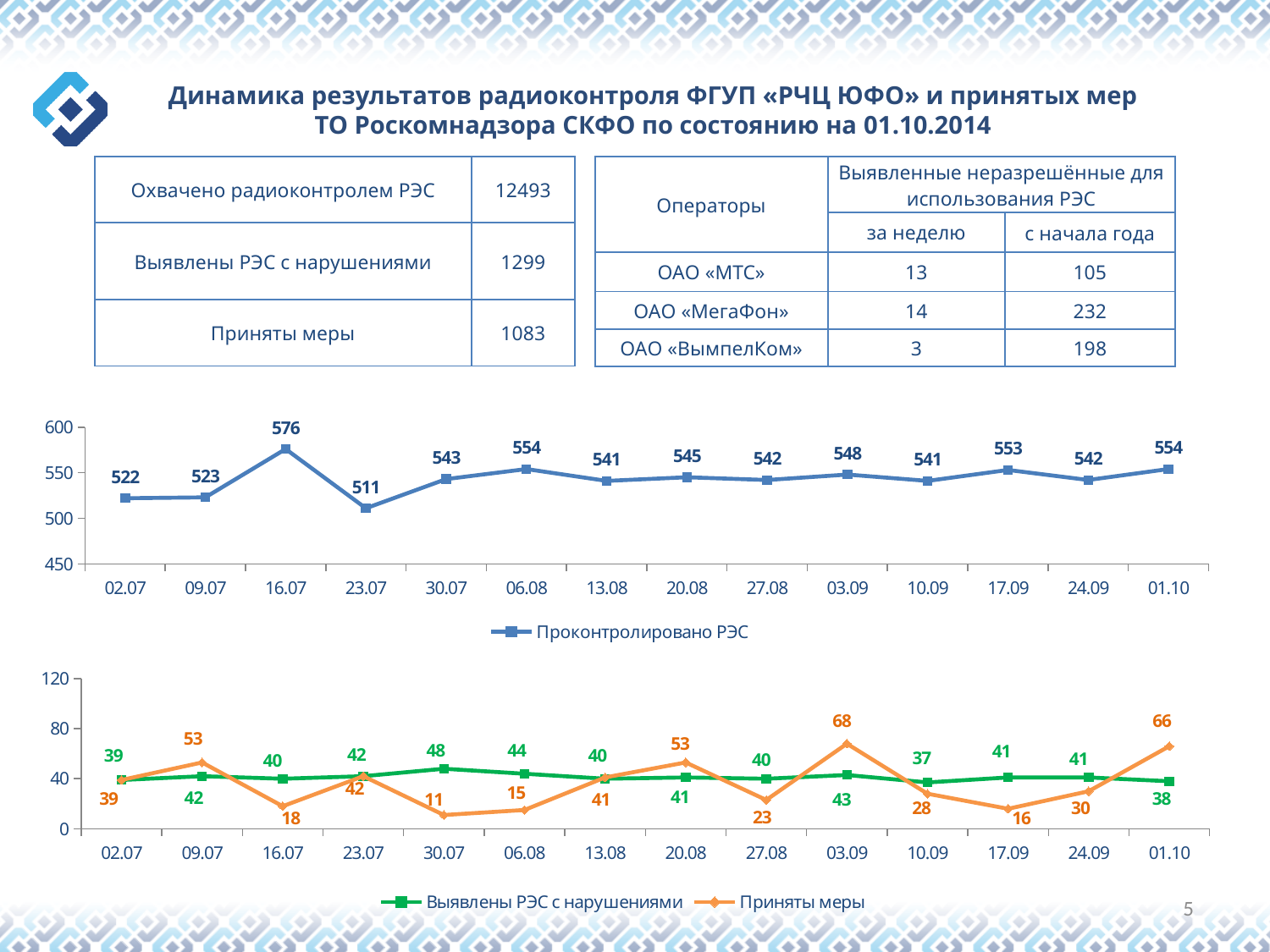
In the bottom chart, what is the difference between Приняты меры and Выявлены РЭС с нарушениями on 16.07? 22 How many data points are plotted in the top chart? 14 What type of chart is the bottom chart? Line chart In the bottom chart, which is larger on 01.10: Выявлены РЭС с нарушениями or Приняты меры? Приняты меры In the top chart, on which date is Проконтролировано РЭС lowest? 23.07 How many series does the legend of the bottom chart list? 2 In the bottom chart, on which date is Выявлены РЭС с нарушениями highest? 30.07 In the top chart, what is the value of Проконтролировано РЭС on 16.07? 576 In the top chart, what is the difference between the values on 16.07 and 23.07? 65 In the bottom chart, what is the value of Приняты меры on 03.09? 68 In the top chart, on which date is Проконтролировано РЭС highest? 16.07 In the bottom chart, on which date is Приняты меры lowest? 30.07